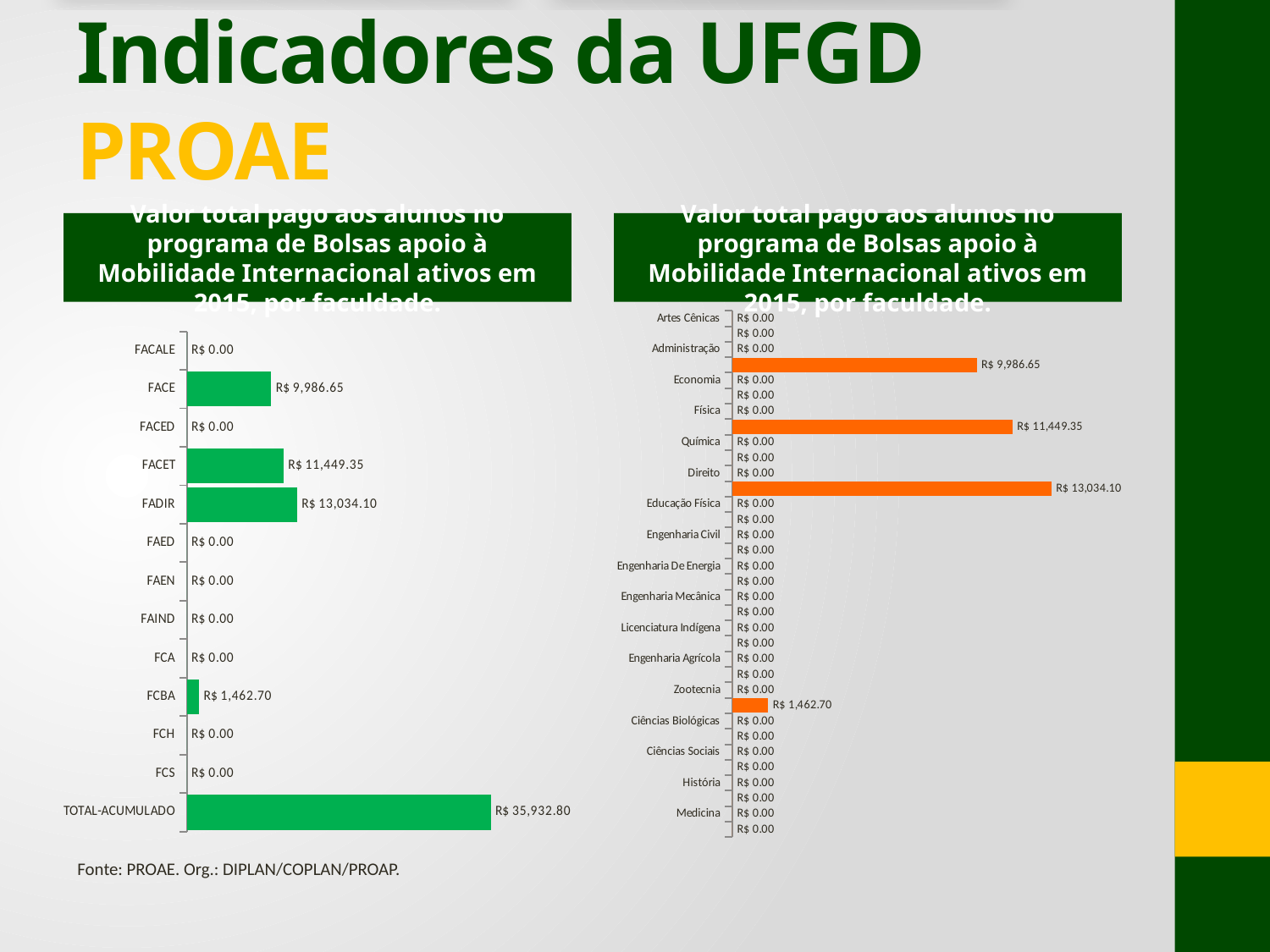
On the left chart, what is the value for TOTAL-ACUMULADO? R$ 35,932.80 On the left chart, which is larger, the value for FACE or the value for FACET? FACET On the right chart, what is the largest value labelled on any bar? R$ 13,034.10 What kind of chart is the left chart? Bar chart On the left chart, what is the value for FCBA? R$ 1,462.70 On the left chart, what is the value for FACET? R$ 11,449.35 How many categories are shown on the left chart? 13 What colour are the bars on the right chart? Orange On the left chart, what is the value for FACE? R$ 9,986.65 On the left chart, what is the difference between the values for FADIR and FACET? R$ 1,584.75 On the left chart, which faculty (excluding TOTAL-ACUMULADO) has the highest value? FADIR On the left chart, what is the difference between the values for FACE and FCBA? R$ 8,523.95